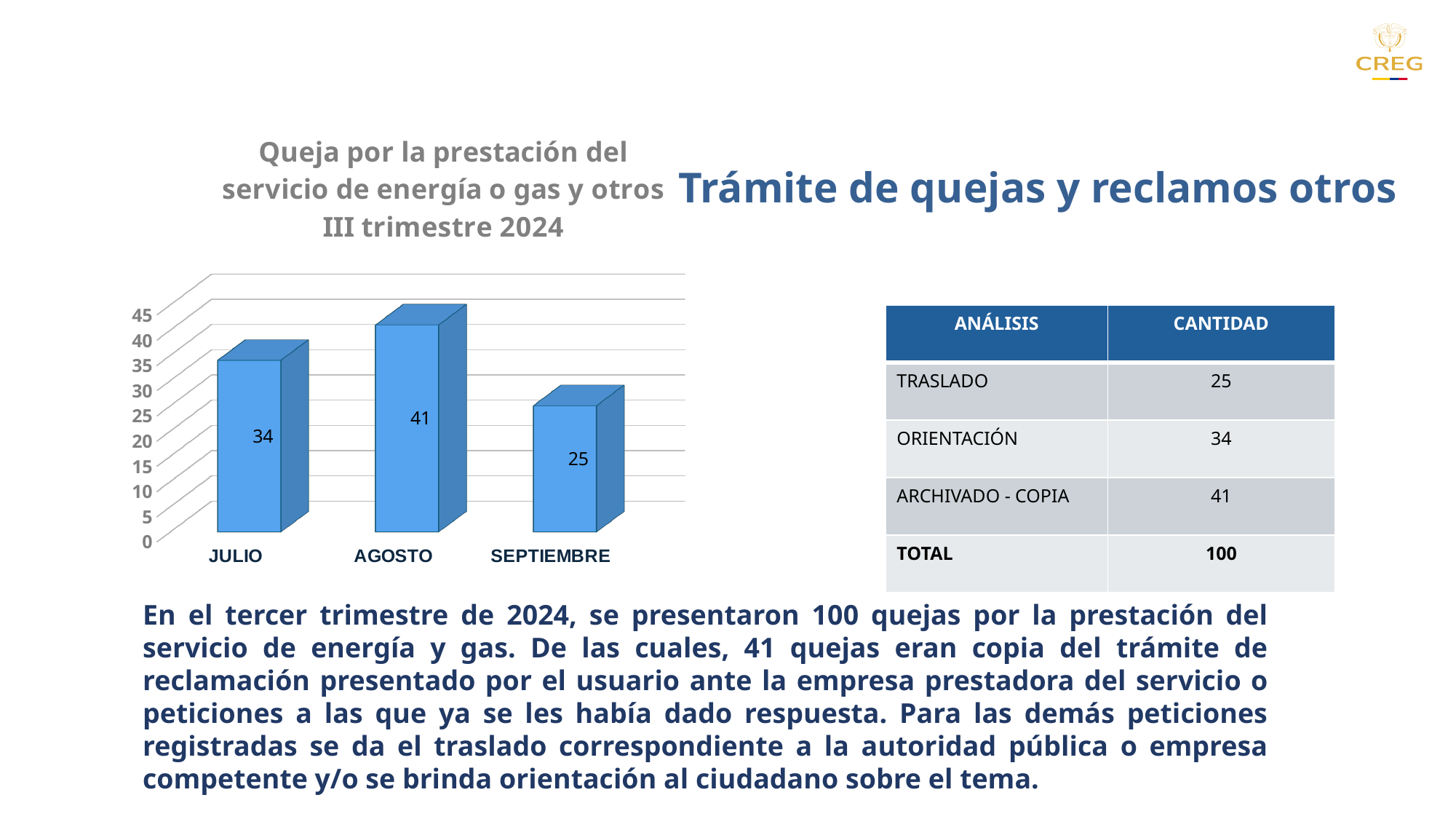
What kind of chart is shown on the slide? bar chart Which month has the highest value in the chart? AGOSTO Which month has the lowest value in the chart? SEPTIEMBRE How many months are shown on the x axis of the chart? 3 Is the value for SEPTIEMBRE greater or less than 30? less What is the value for AGOSTO in the chart? 41 What is the difference between the values for JULIO and SEPTIEMBRE? 9 What is the value for JULIO in the chart? 34 What is the difference between the values for AGOSTO and SEPTIEMBRE? 16 Which is larger, the value for JULIO or the value for AGOSTO? AGOSTO What is the title of the chart? Queja por la prestación del servicio de energía o gas y otros III trimestre 2024 What is the value for SEPTIEMBRE in the chart? 25